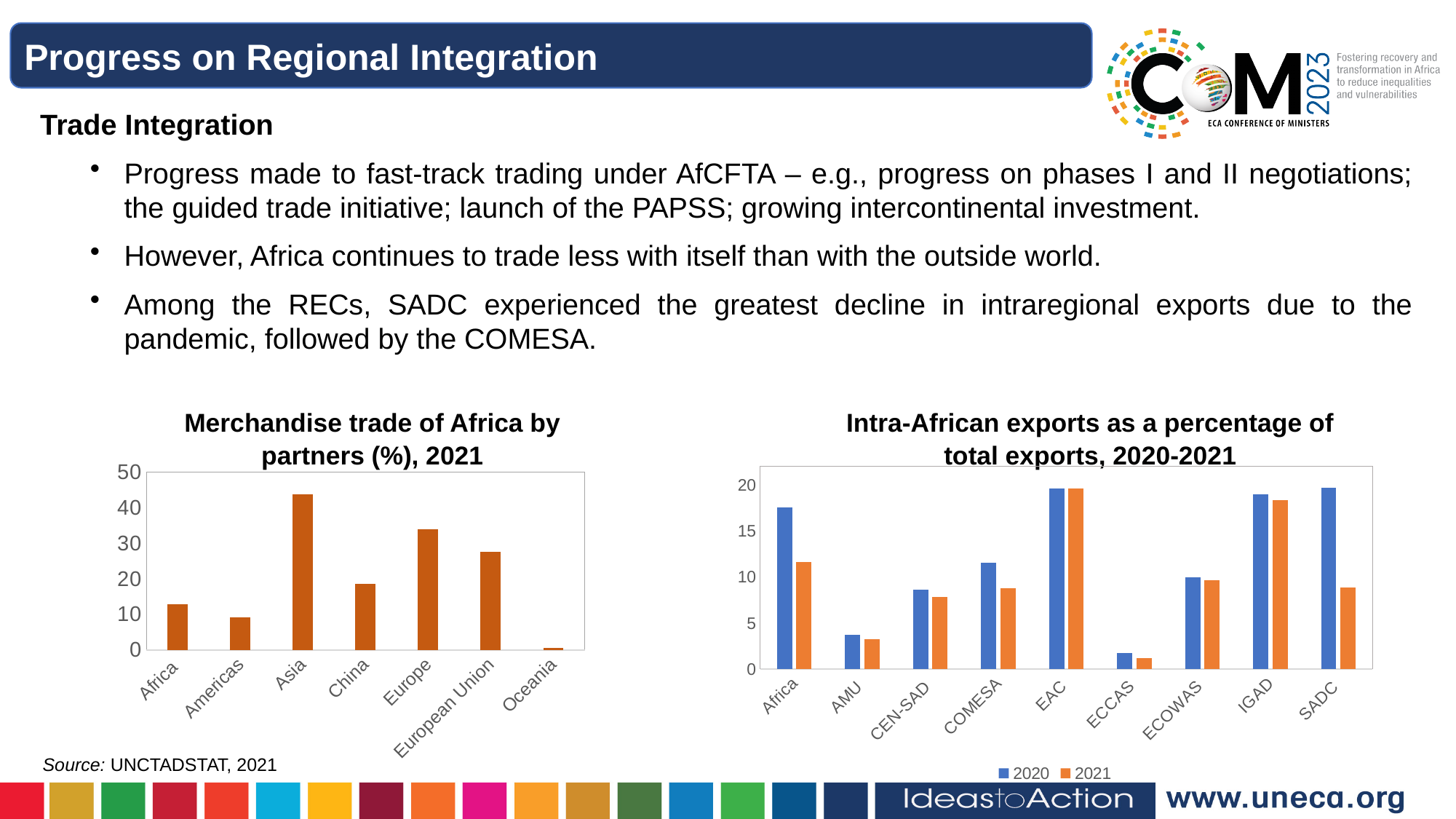
In the 'Intra-African exports as a percentage of total exports, 2020-2021' chart, which is larger for SADC, the 2020 value or the 2021 value? 2020 In the 'Merchandise trade of Africa by partners (%), 2021' chart, is the value for Africa greater or less than 20? less In the 'Merchandise trade of Africa by partners (%), 2021' chart, which partner has the highest value? Asia In the 'Intra-African exports as a percentage of total exports, 2020-2021' chart, which category has the lowest 2021 value? ECCAS What kind of chart is the 'Merchandise trade of Africa by partners (%), 2021' chart? bar chart How many partner categories are shown in the 'Merchandise trade of Africa by partners (%), 2021' chart? 7 How many series does the legend list in the 'Intra-African exports as a percentage of total exports, 2020-2021' chart? 2 In the 'Merchandise trade of Africa by partners (%), 2021' chart, is the value for Europe greater or less than 30? greater In the 'Merchandise trade of Africa by partners (%), 2021' chart, which is larger, the value for China or the value for Americas? China In the 'Merchandise trade of Africa by partners (%), 2021' chart, which partner has the lowest value? Oceania In the 'Intra-African exports as a percentage of total exports, 2020-2021' chart, is the 2020 value for SADC greater or less than 15? greater How many regional categories are shown on the x axis of the 'Intra-African exports as a percentage of total exports, 2020-2021' chart? 9